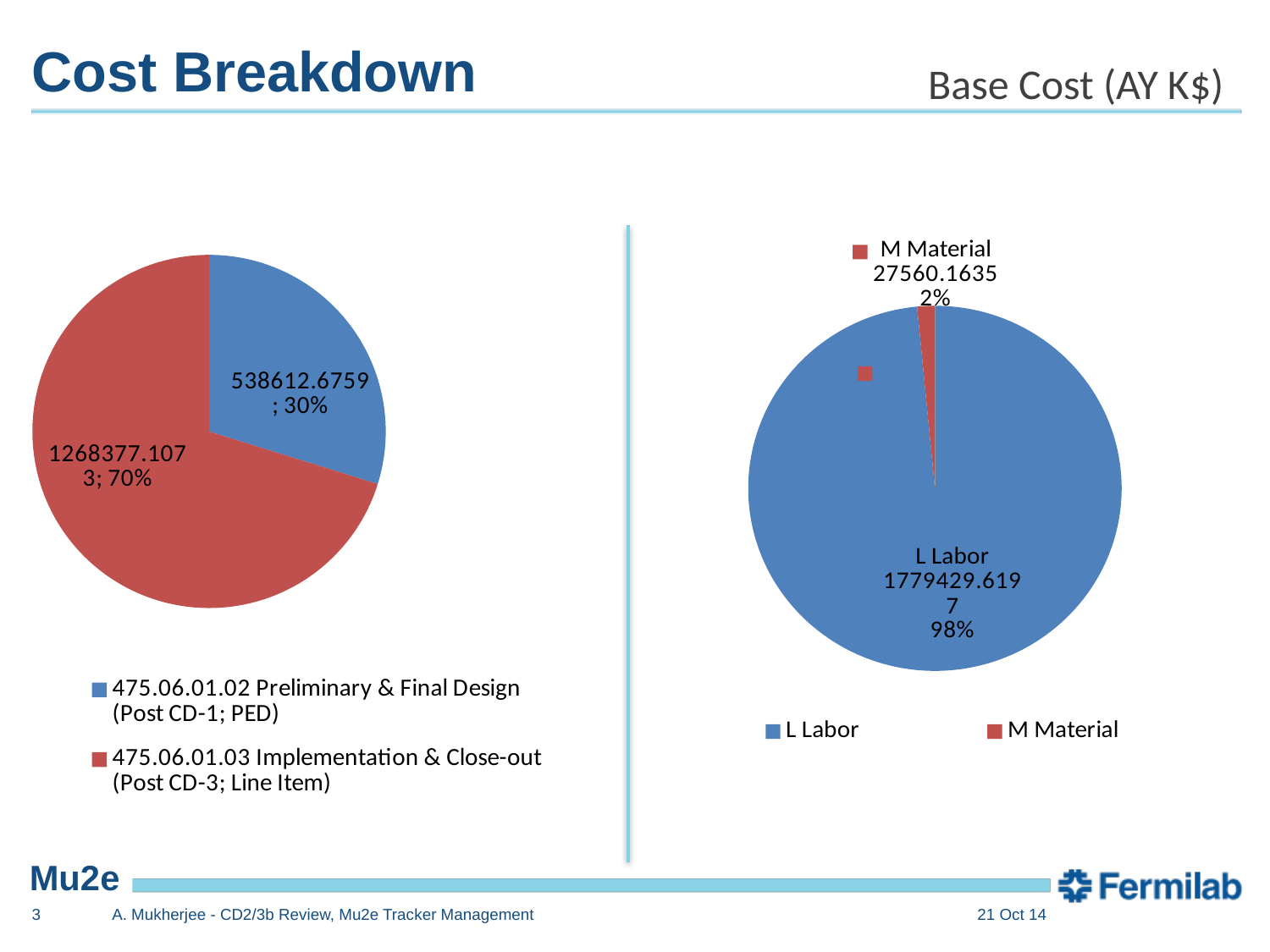
In the right pie chart, what is the value shown for L Labor? 1779429.6197 In the left pie chart, which slice is the largest? 475.06.01.03 Implementation & Close-out (Post CD-3; Line Item) In the left pie chart, what is the value shown for 475.06.01.02 Preliminary & Final Design (Post CD-1; PED)? 538612.6759 In the left pie chart, what share of the pie does 475.06.01.03 Implementation & Close-out (Post CD-3; Line Item) represent? 70% In the right pie chart, which slice is the smallest? M Material In the left pie chart, what share of the pie does 475.06.01.02 Preliminary & Final Design (Post CD-1; PED) represent? 30% How many slices does the left pie chart have? 2 In the right pie chart, what is the value shown for M Material? 27560.1635 In the left pie chart, what is the value shown for 475.06.01.03 Implementation & Close-out (Post CD-3; Line Item)? 1268377.1073 How many entries does the legend of the right pie chart list? 2 What type of chart is the left chart on the slide? pie chart In the right pie chart, what share of the pie does M Material represent? 2%